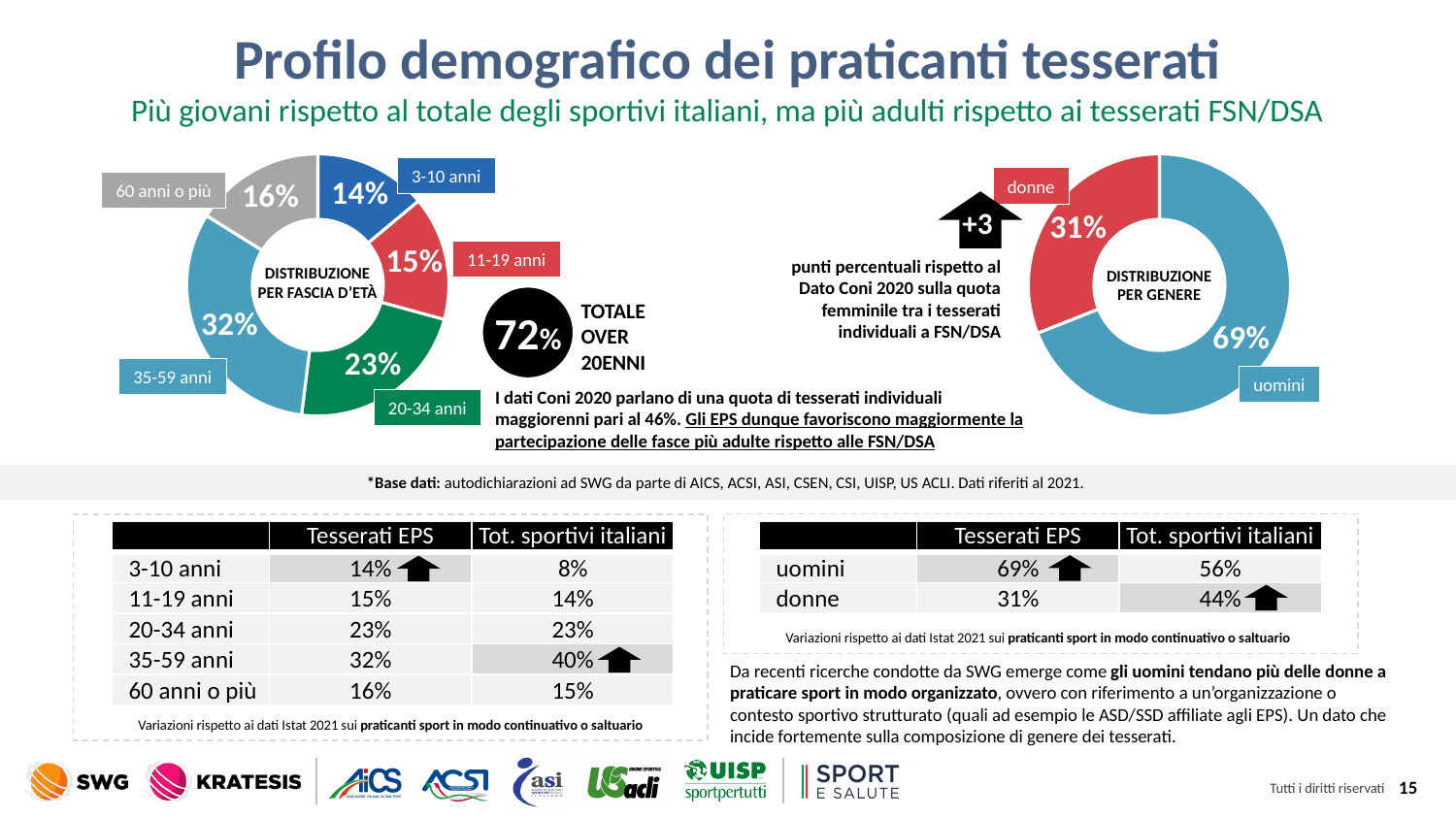
How many age groups are shown in the 'Distribuzione per fascia d'età' chart? 5 In the 'Distribuzione per fascia d'età' chart, which age group has the smallest share? 3-10 anni In the 'Distribuzione per genere' chart, what share is shown for donne? 31% What kind of chart is the 'Distribuzione per fascia d'età' chart? Donut (pie) chart In the 'Distribuzione per fascia d'età' chart, what is the difference between the shares for 35-59 anni and 20-34 anni? 9 percentage points In the 'Distribuzione per genere' chart, what share is shown for uomini? 69% In the 'Distribuzione per fascia d'età' chart, what share is shown for 35-59 anni? 32% In the 'Distribuzione per fascia d'età' chart, what share is shown for 3-10 anni? 14% In the 'Distribuzione per genere' chart, what is the difference between the shares for uomini and donne? 38 percentage points In the 'Distribuzione per fascia d'età' chart, what share is shown for 20-34 anni? 23% In the 'Distribuzione per fascia d'età' chart, which age group has the largest share? 35-59 anni In the 'Distribuzione per fascia d'età' chart, which is larger: the share for 60 anni o più or the share for 11-19 anni? 60 anni o più